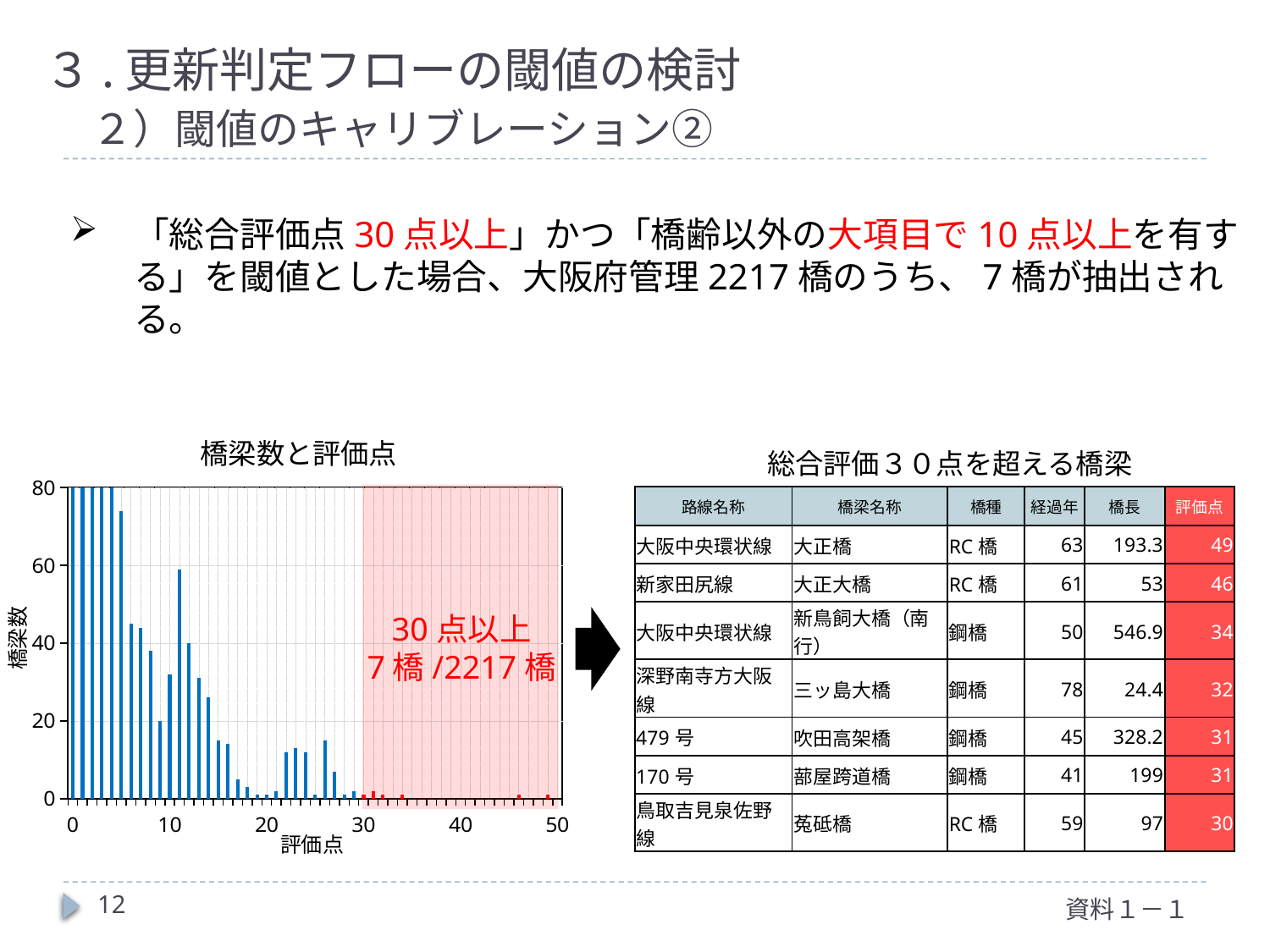
Do the values generally rise or fall as 評価点 increases from 11 to 20? fall Is the value for 評価点 5 greater or less than 60? greater Is the value for 評価点 9 greater or less than 40? less Is the value for 評価点 26 greater or less than 20? less Which has the larger value, 評価点 5 or 評価点 11? 評価点 5 Which has the larger value, 評価点 11 or 評価点 9? 評価点 11 What text is written inside the red shaded region of the chart? 30点以上 7橋/2217橋 What is the title of the chart on the slide? 橋梁数と評価点 What kind of chart is shown on the slide? bar chart